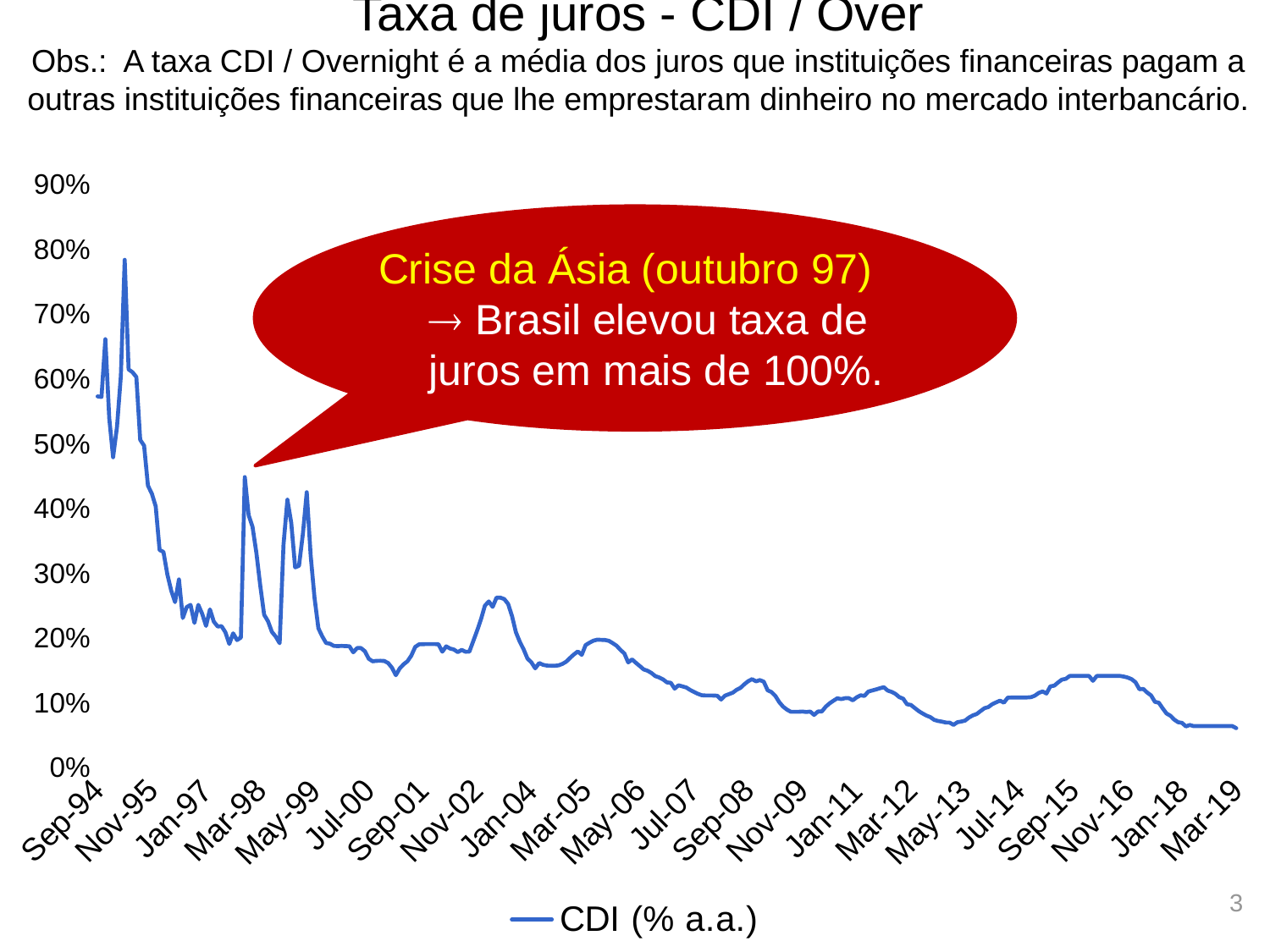
Is the CDI value at Sep-94 greater or less than 50%? greater Which is larger, the CDI value at Sep-15 or at Mar-19? Sep-15 Is the lowest CDI value on the chart greater or less than 10%? less Is the CDI value at Mar-19 greater or less than 10%? less What kind of chart is shown on the slide? line chart Overall, does the CDI rate rise or fall from Sep-94 to Mar-19? fall What is the name of the series shown in the legend? CDI (% a.a.) How many series does the legend list? 1 What is the title of the chart? Taxa de juros - CDI / Over Which is larger, the CDI value at Sep-94 or at Mar-19? Sep-94